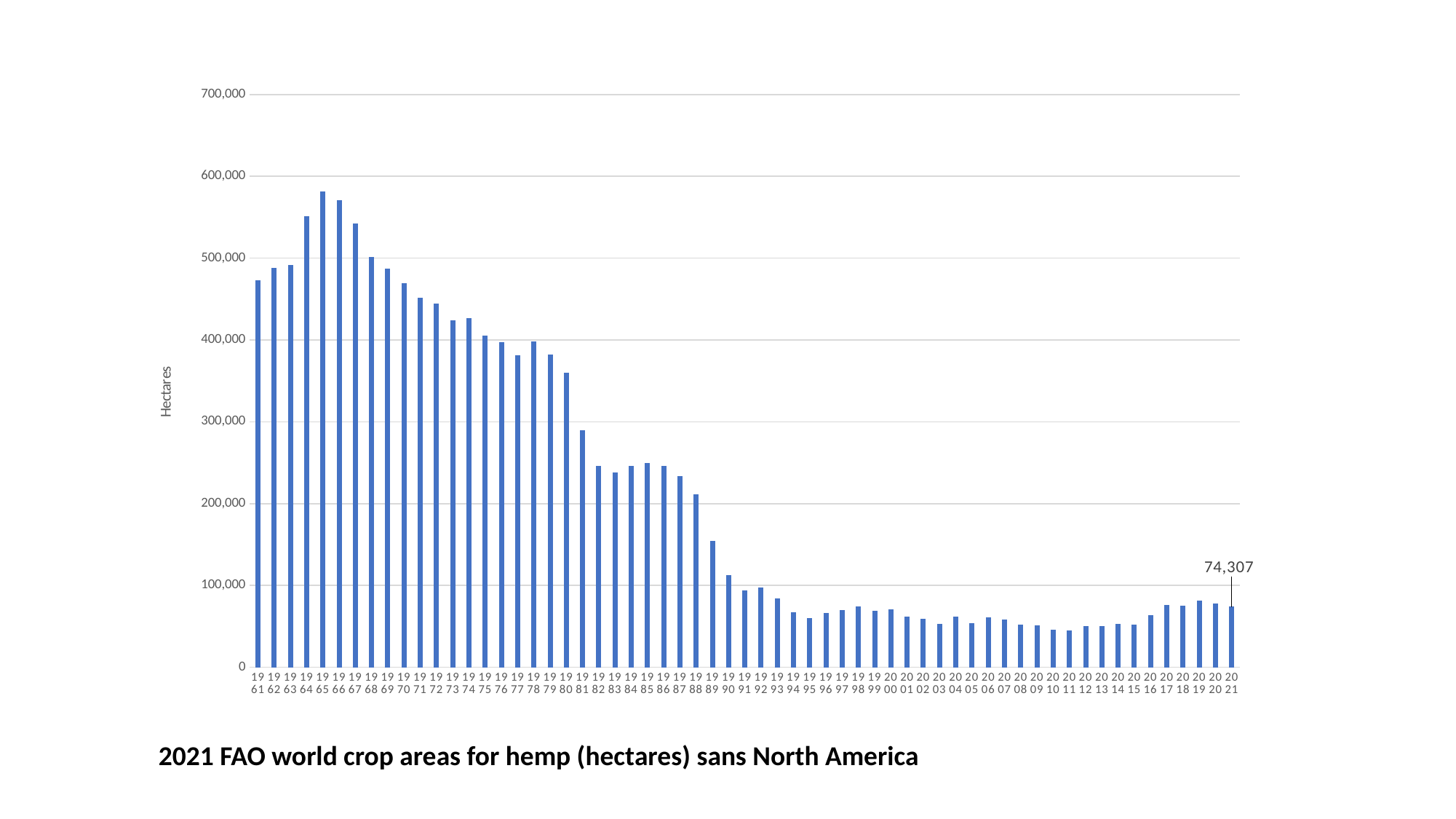
Do the values generally rise or fall from 1961 to 2021? fall How many years (bars) are plotted on the chart? 61 Which is larger, the value for 2019 or the value for 2015? 2019 What is the value for 2021? 74,307 Is the value for 1989 greater or less than 100,000? greater Is the value for 1961 greater or less than 400,000? greater Is the value for 2000 greater or less than 100,000? less What is the label on the vertical axis? Hectares Which year has the highest value? 1965 Which is larger, the value for 1961 or the value for 1980? 1961 What kind of chart is shown on the slide? bar chart